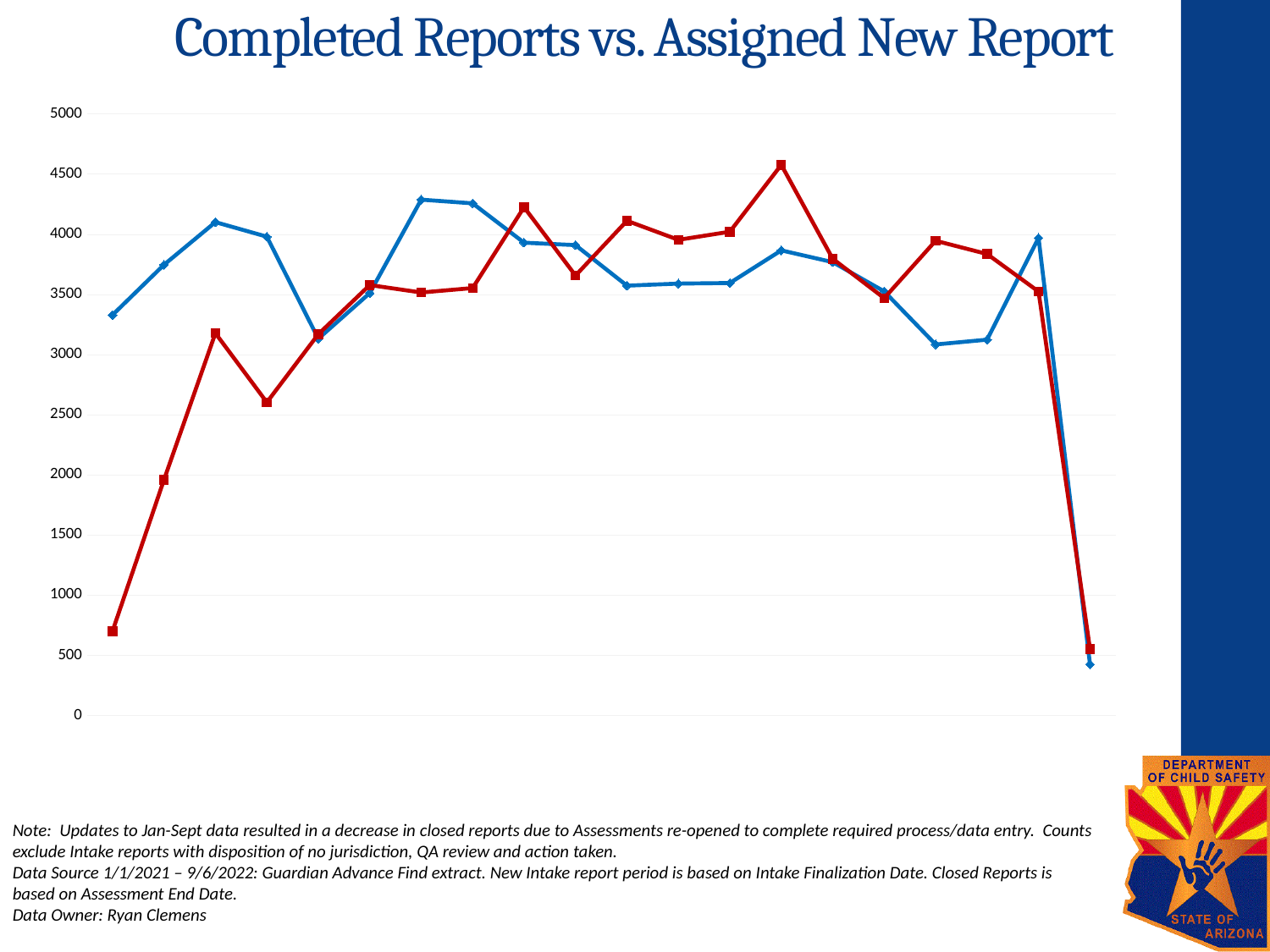
What is the highest value shown on the vertical axis? 5000 How many lines (data series) are plotted on the chart? 2 Which line reaches the highest value on the chart, the blue line or the red line? red line Is the highest point of the red line greater or less than 4500? greater What is the title of the chart? Completed Reports vs. Assigned New Report Is the first point of the red line greater or less than 1000? less Is the last point of the blue line greater or less than 1000? less What colours are the two lines on the chart? blue and red What kind of chart is shown on the slide? line chart At the first point on the x axis, which line has the larger value, blue or red? blue Does the red line rise or fall over its first three points? rise